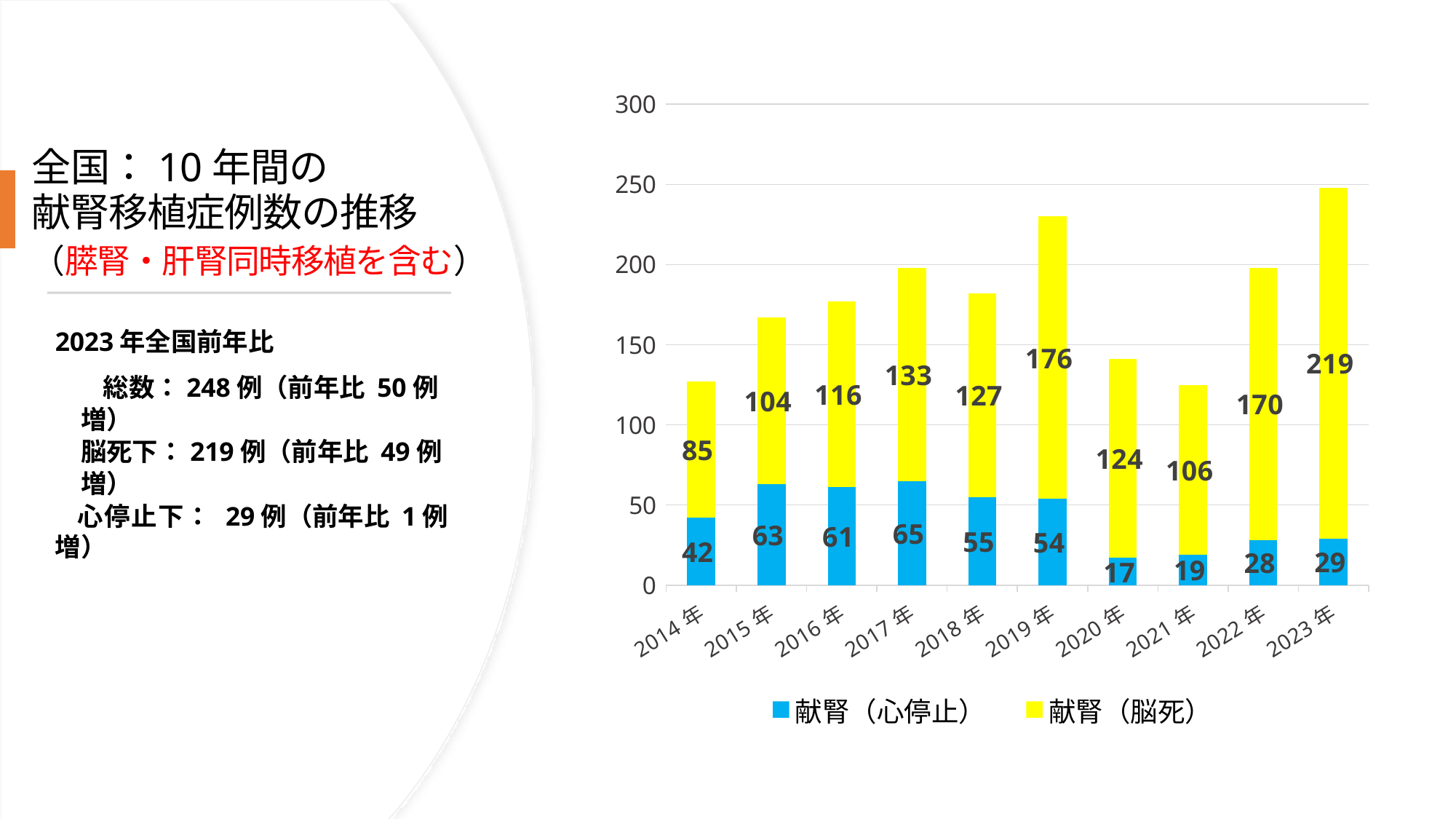
Which year has the highest value for 献腎（脳死）? 2023年 Which is larger, the 献腎（心停止） value for 2015年 or for 2016年? 2015年 How many series does the legend list? 2 What is the value for 献腎（脳死） in 2023年? 219 Which year has the lowest value for 献腎（心停止）? 2020年 What is the total of the stacked bar for 2023年? 248 What is the difference between the 献腎（脳死） values for 2023年 and 2022年? 49 Which colour represents 献腎（心停止） in the chart? blue What is the value for 献腎（心停止） in 2017年? 65 How many years are shown on the x axis? 10 Is the total stacked bar for 2019年 greater or less than 200? greater What kind of chart is shown on the slide? stacked bar chart